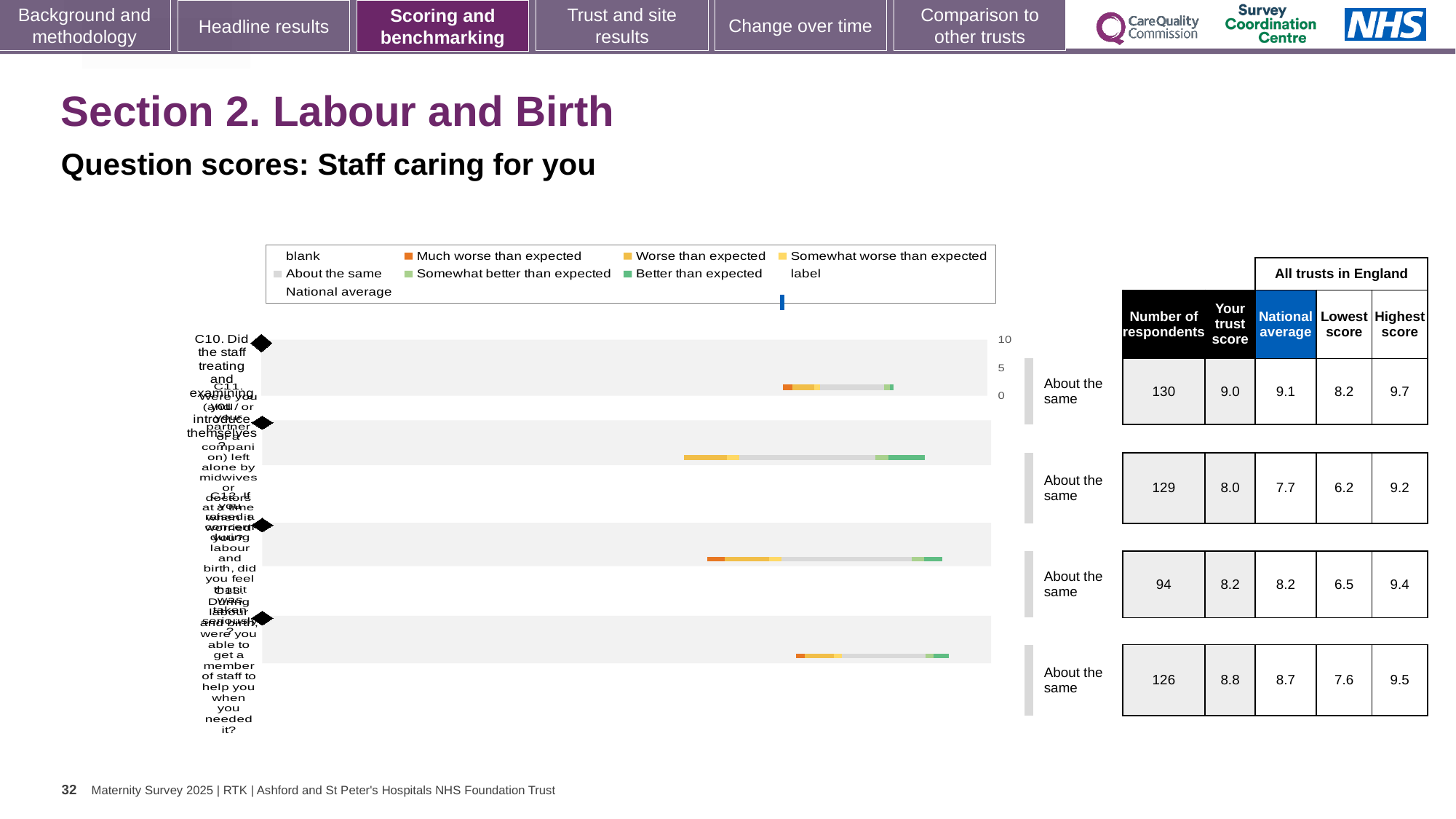
Which colour does the legend use for 'Much worse than expected'? orange Which row has the highest number of respondents in the table next to the chart? the first row, C10 (130) In the table next to the chart, what is the highest score for the third row, C12? 9.4 Which row has the lowest number of respondents in the table next to the chart? the third row, C12 (94) In the table next to the chart, what is the national average for the fourth (bottom) row, C13? 8.7 In the table next to the chart, what is the number of respondents for the first (top) row, C10? 130 How many question rows are plotted in the chart? 4 What benchmark category is shown for every row of the chart? About the same For the second row, C11, what is the difference between the highest score and the lowest score? 3.0 What kind of chart is shown on the slide? bar chart For the second row, C11, is the trust score or the national average larger? trust score (8.0) In the table next to the chart, what is the trust score for the second row, C11? 8.0